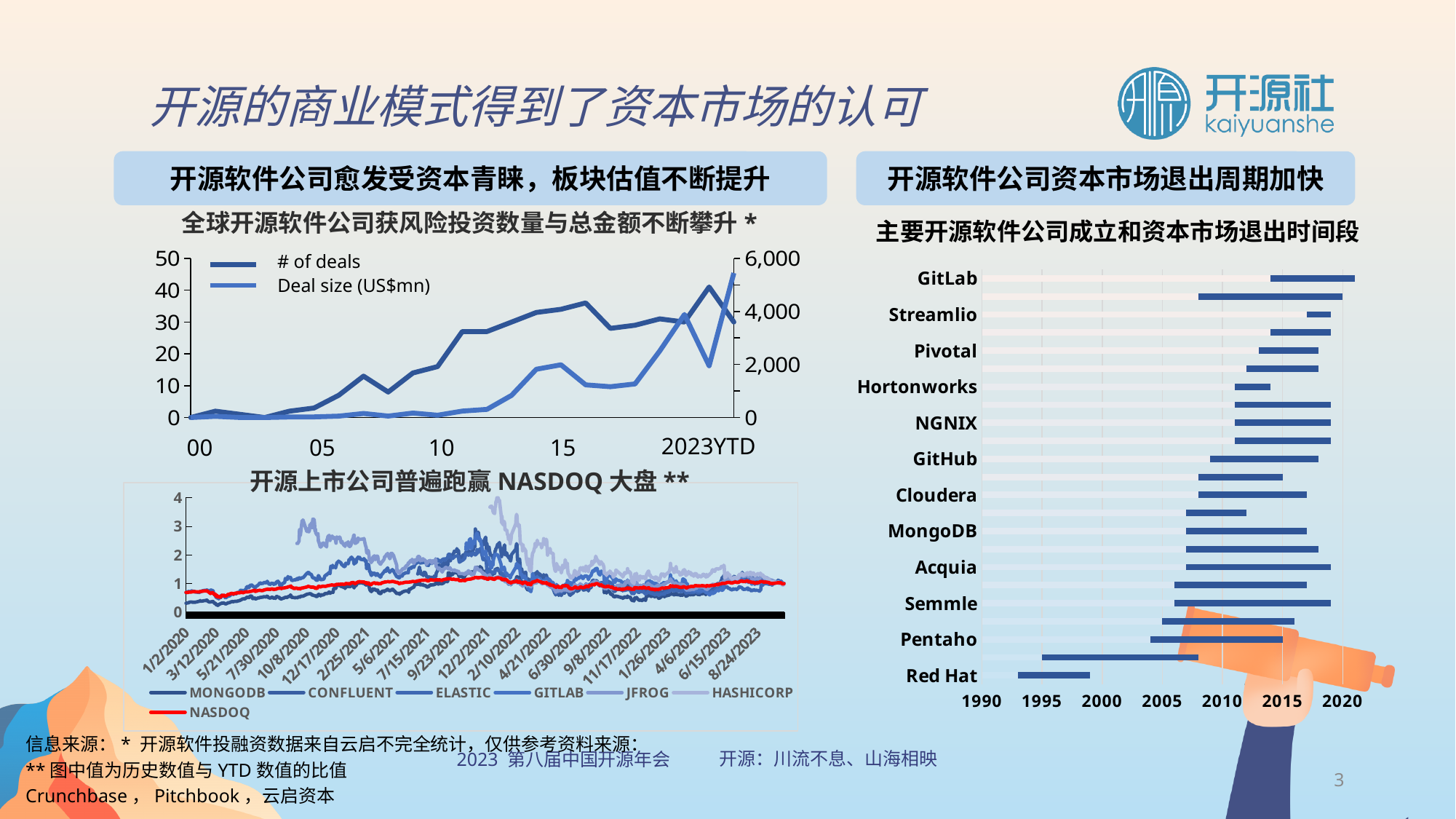
How many companies are listed on the vertical axis of the right-hand chart '主要开源软件公司成立和资本市场退出时间段'? 12 What kind of chart is the top-left chart titled '全球开源软件公司获风险投资数量与总金额不断攀升 *'? line chart In the top-left chart '全球开源软件公司获风险投资数量与总金额不断攀升 *', is the 'Deal size (US$mn)' value at 2023YTD greater or less than 4,000? greater How many series does the legend of the bottom-left chart '开源上市公司普遍跑赢 NASDOQ 大盘 **' list? 7 What kind of chart is the bottom-left chart '开源上市公司普遍跑赢 NASDOQ 大盘 **'? line chart In the top-left chart '全球开源软件公司获风险投资数量与总金额不断攀升 *', what are the two series named in the legend? # of deals; Deal size (US$mn) In the right-hand chart '主要开源软件公司成立和资本市场退出时间段', which company's bar starts earliest on the time axis? Red Hat In the top-left chart '全球开源软件公司获风险投资数量与总金额不断攀升 *', do the values for '# of deals' generally rise or fall from 00 to 2023YTD? rise What kind of chart is the right-hand chart '主要开源软件公司成立和资本市场退出时间段'? bar chart How many series does the legend of the top-left chart '全球开源软件公司获风险投资数量与总金额不断攀升 *' list? 2 In the top-left chart '全球开源软件公司获风险投资数量与总金额不断攀升 *', is the '# of deals' value at 05 greater or less than 10? less In the bottom-left chart '开源上市公司普遍跑赢 NASDOQ 大盘 **', which series is drawn in red? NASDOQ